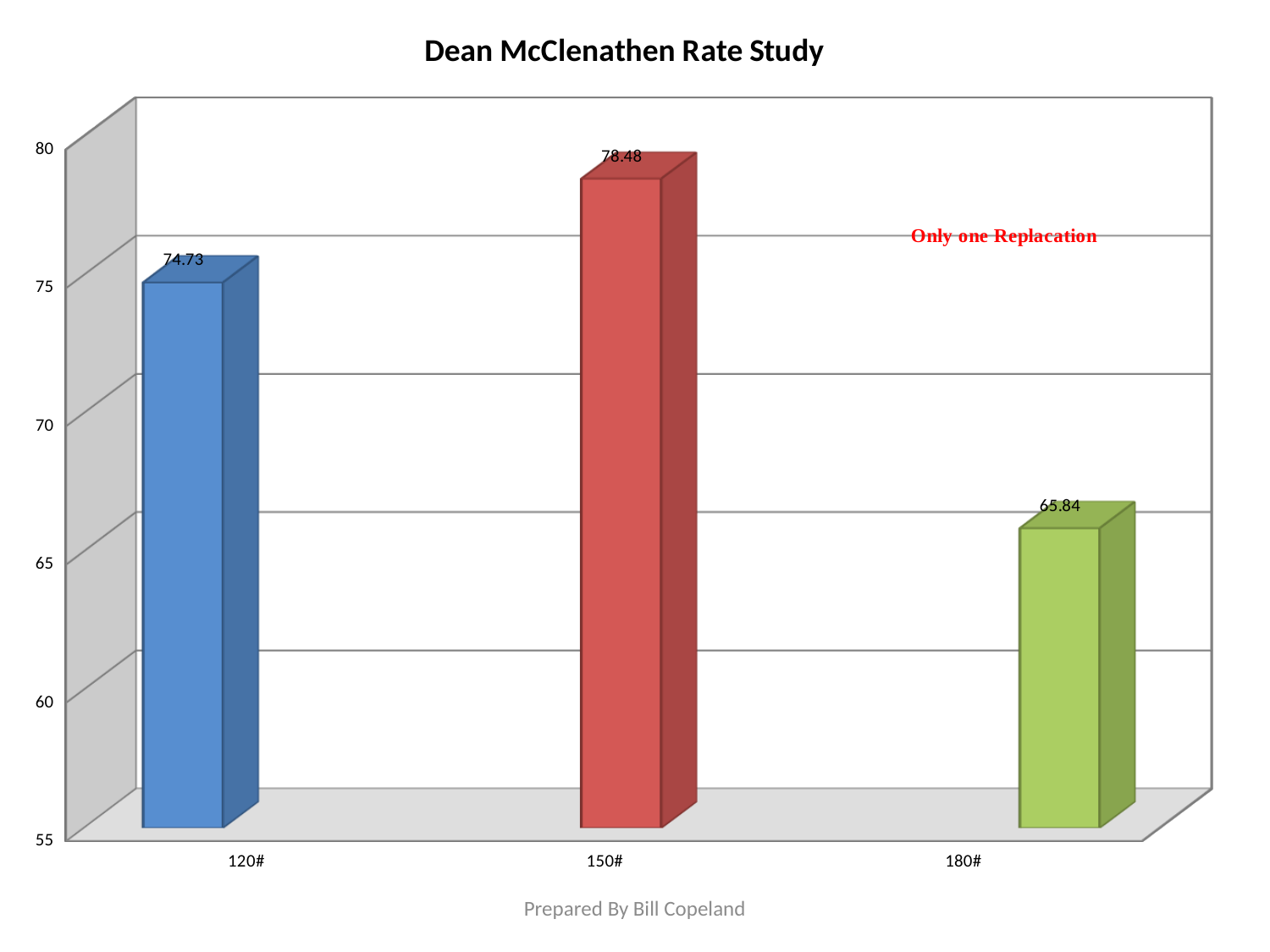
How many categories are shown on the x axis? 3 What is the difference between the values for 150# and 120#? 3.75 What is the title of the chart? Dean McClenathen Rate Study What is the value for 180#? 65.84 Which is larger, the value for 120# or the value for 180#? 120# Which category has the highest value? 150# What kind of chart is shown on the slide? bar chart Which category has the lowest value? 180# What is the difference between the values for 120# and 180#? 8.89 What is the value for 150#? 78.48 What is the value for 120#? 74.73 Is the value for 180# greater or less than 70? less